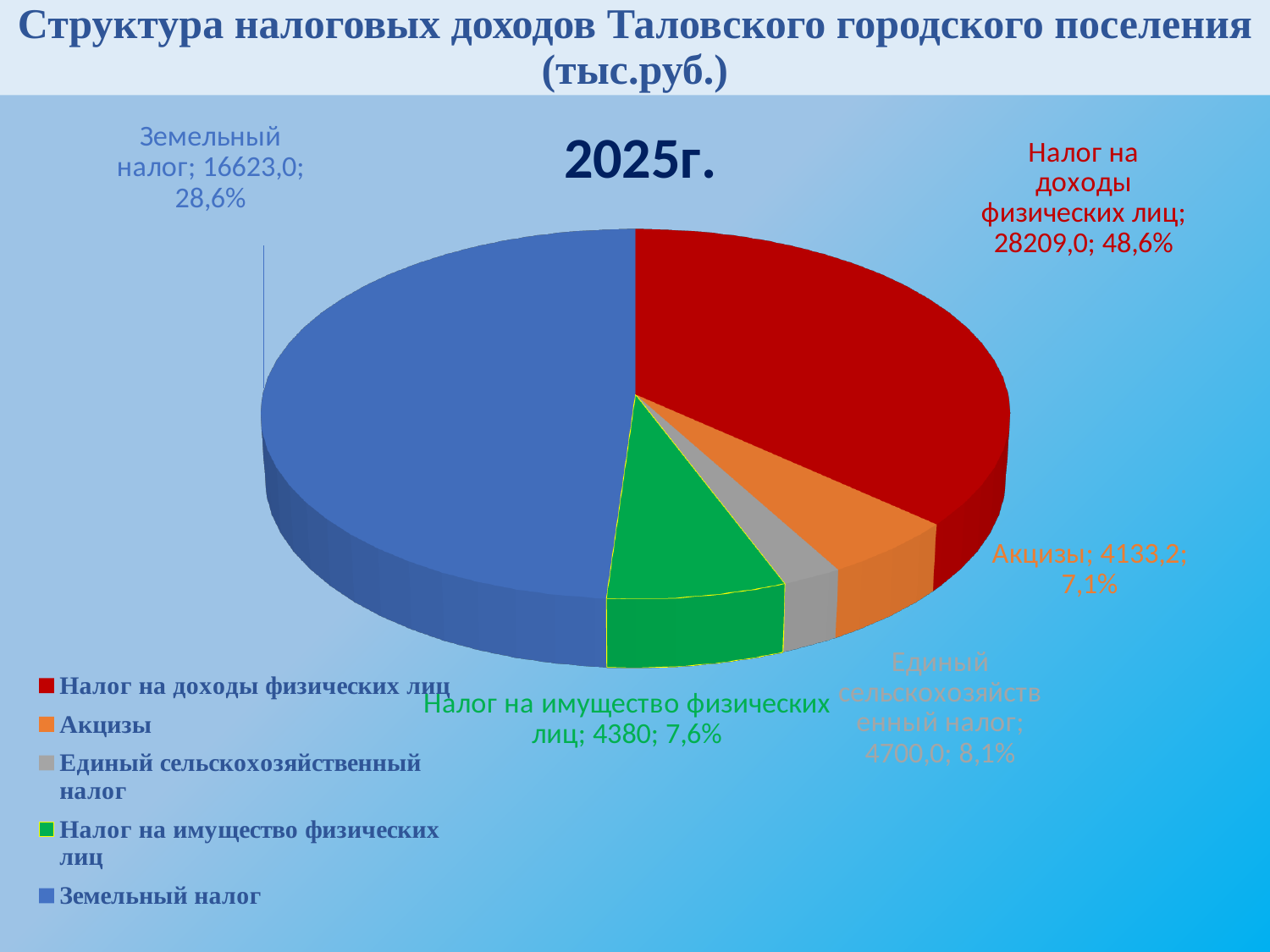
What year is shown as the chart title? 2025г. What is the difference between the values for Налог на доходы физических лиц and Земельный налог? 11586,0 What value is shown for Налог на доходы физических лиц in the pie chart? 28209,0 What value is shown for Акцизы? 4133,2 What value is shown for Налог на имущество физических лиц? 4380 What kind of chart is shown on the slide? Pie chart What share of the pie does Земельный налог represent? 28,6% How many categories are shown in the pie chart? 5 What share of the pie does Единый сельскохозяйственный налог represent? 8,1%